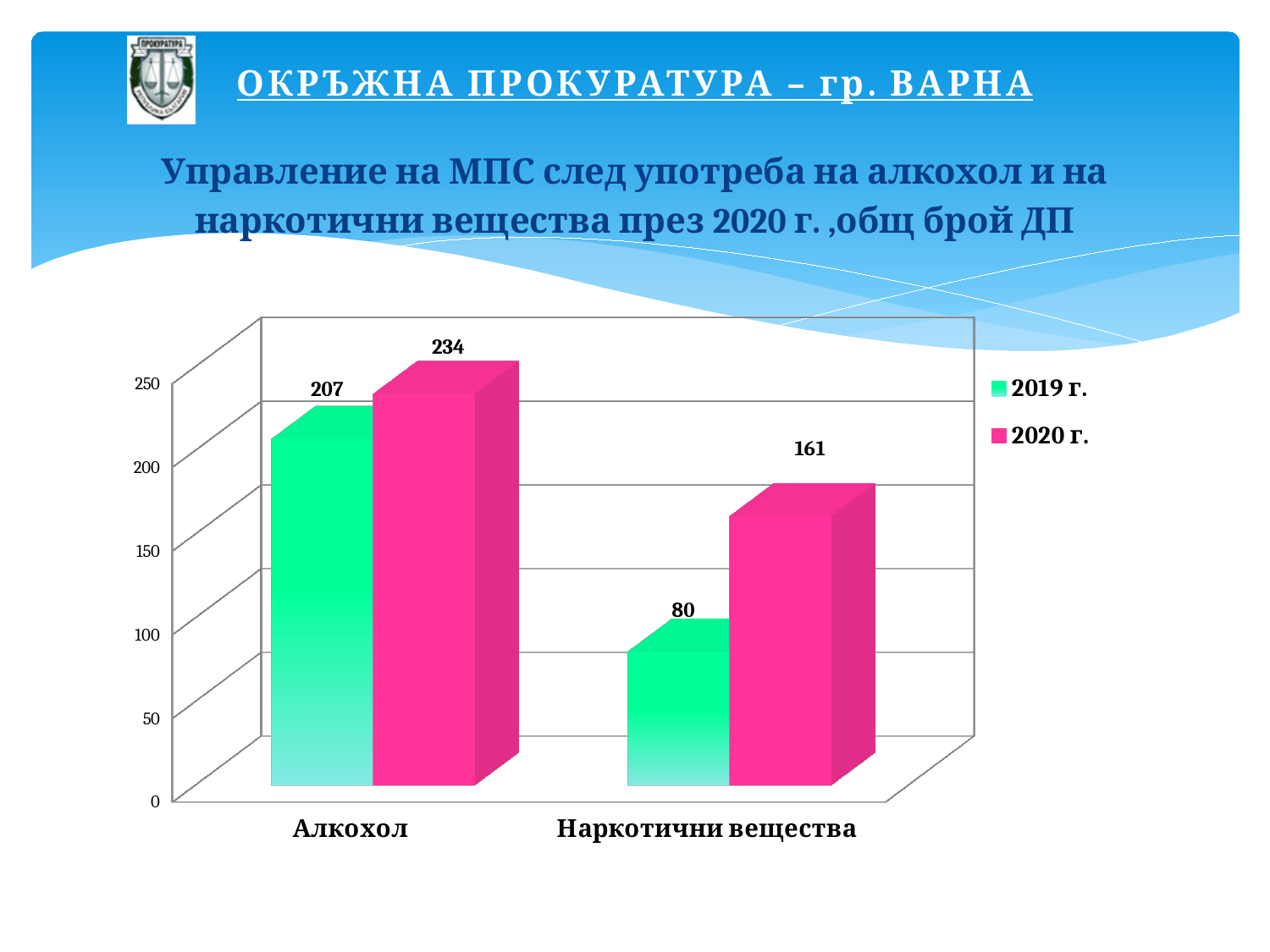
What is the value for Наркотични вещества in the 2020 г. series? 161 What is the value for Алкохол in the 2019 г. series? 207 How many series does the legend list? 2 Which is larger: the 2019 г. value for Алкохол or the 2020 г. value for Наркотични вещества? 2019 г. value for Алкохол How many categories are shown on the x axis? 2 Which category has the highest value in the 2020 г. series? Алкохол What is the difference between the 2020 г. and 2019 г. values for Алкохол? 27 What kind of chart is shown on the slide? Bar chart What is the value for Алкохол in the 2020 г. series? 234 What is the difference between the 2020 г. and 2019 г. values for Наркотични вещества? 81 Which category has the lowest value in the 2019 г. series? Наркотични вещества What is the value for Наркотични вещества in the 2019 г. series? 80